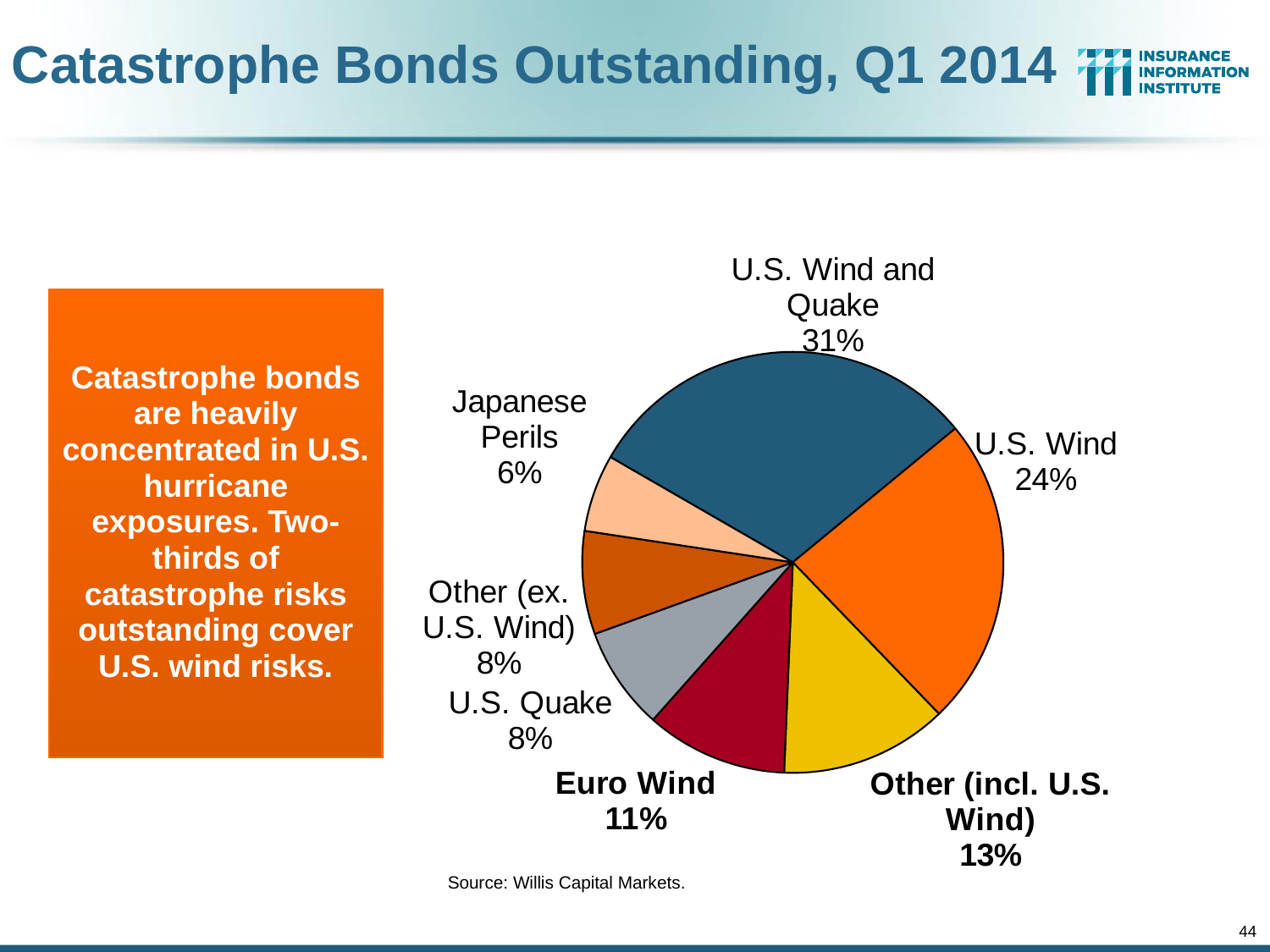
What is the source cited for the chart? Willis Capital Markets What is the value for Other (incl. U.S. Wind)? 13% What percentage does the U.S. Wind slice represent? 24% Which is larger, Euro Wind or U.S. Quake? Euro Wind Which category has the largest slice of the pie? U.S. Wind and Quake What share is shown for Euro Wind? 11% Which category has the smallest slice of the pie? Japanese Perils What is the value for Japanese Perils? 6% How many slices does the pie chart have? 7 What is the difference in percentage points between U.S. Wind and Quake and U.S. Wind? 7 What share of catastrophe bonds outstanding is U.S. Wind and Quake? 31% What kind of chart is shown on the slide? pie chart